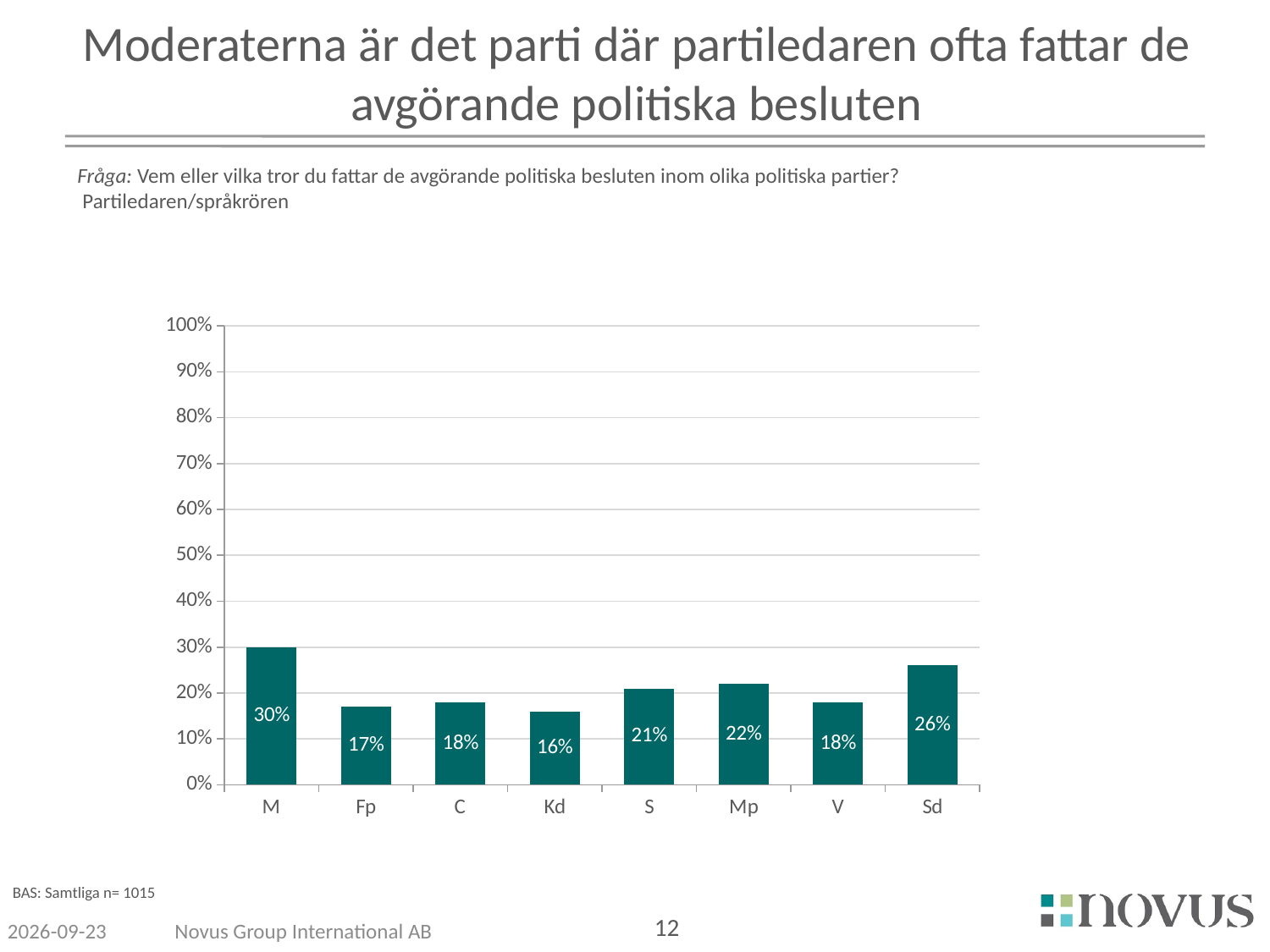
Which party has the lowest value? Kd Is the value for M greater or less than 20%? greater What is the highest value shown on the y axis? 100% What is the value for Mp? 22% What is the value for Sd? 26% What is the difference between the values for M and Sd? 4% What kind of chart is shown on the slide? bar chart What is the value for M? 30% How many parties are shown on the x axis? 8 Which party has the highest value? M Which is larger, the value for Mp or the value for Fp? Mp What is the difference between the values for S and Kd? 5%